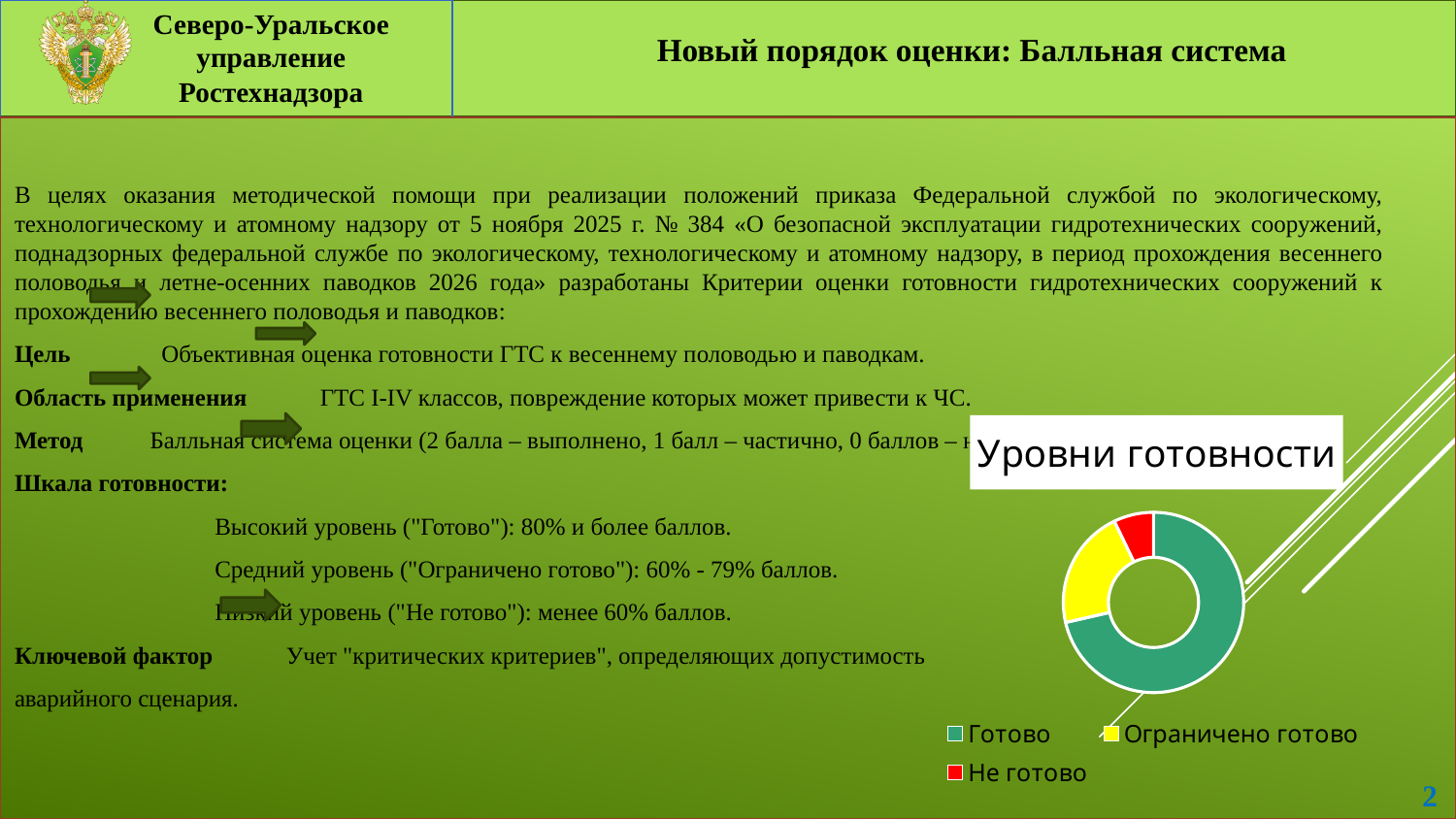
How many categories does the legend of the chart list? 3 Which category in the chart is shown in yellow? Ограничено готово Which is larger in the chart: the share for Готово or the share for Ограничено готово? Готово What colour represents the category Не готово in the chart? red Which category has the largest share of the doughnut chart? Готово Which category has the smallest share of the doughnut chart? Не готово What kind of chart is shown on the slide? doughnut chart What is the title of the chart on the slide? Уровни готовности Which is larger in the chart: the share for Ограничено готово or the share for Не готово? Ограничено готово